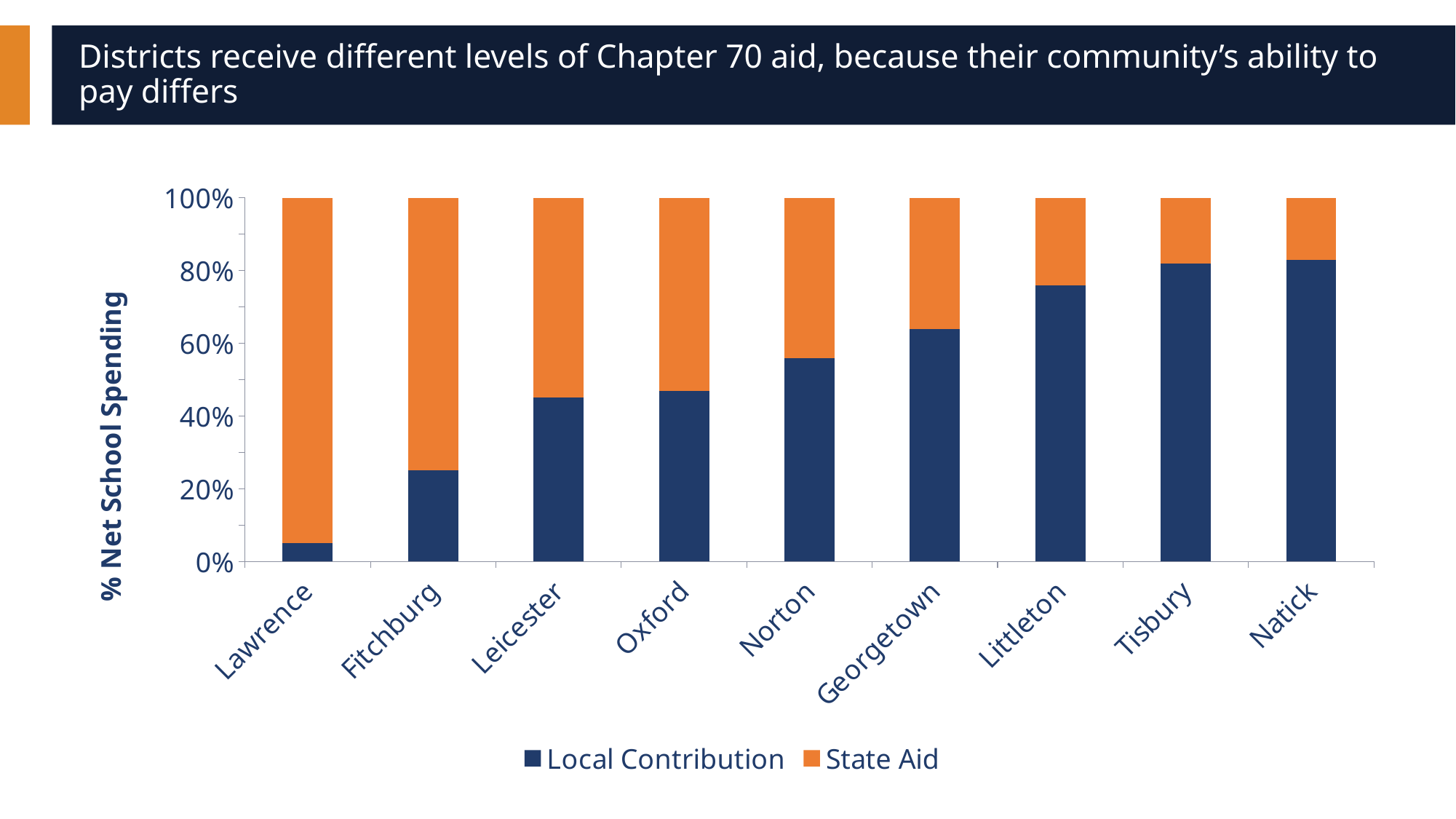
Is the State Aid for Lawrence greater or less than 80%? greater Which district has the lowest Local Contribution share? Lawrence Is the Local Contribution for Norton greater or less than 40%? greater Which has the larger Local Contribution share, Fitchburg or Leicester? Leicester What is the total of the stacked bar for Georgetown? 100% Which district has the highest State Aid share? Lawrence Is the Local Contribution for Lawrence greater or less than 20%? less What kind of chart is shown on the slide? Stacked bar chart How many districts are shown on the x axis? 9 Does the Local Contribution share rise or fall moving from Lawrence to Natick along the x axis? Rise How many series does the legend list? 2